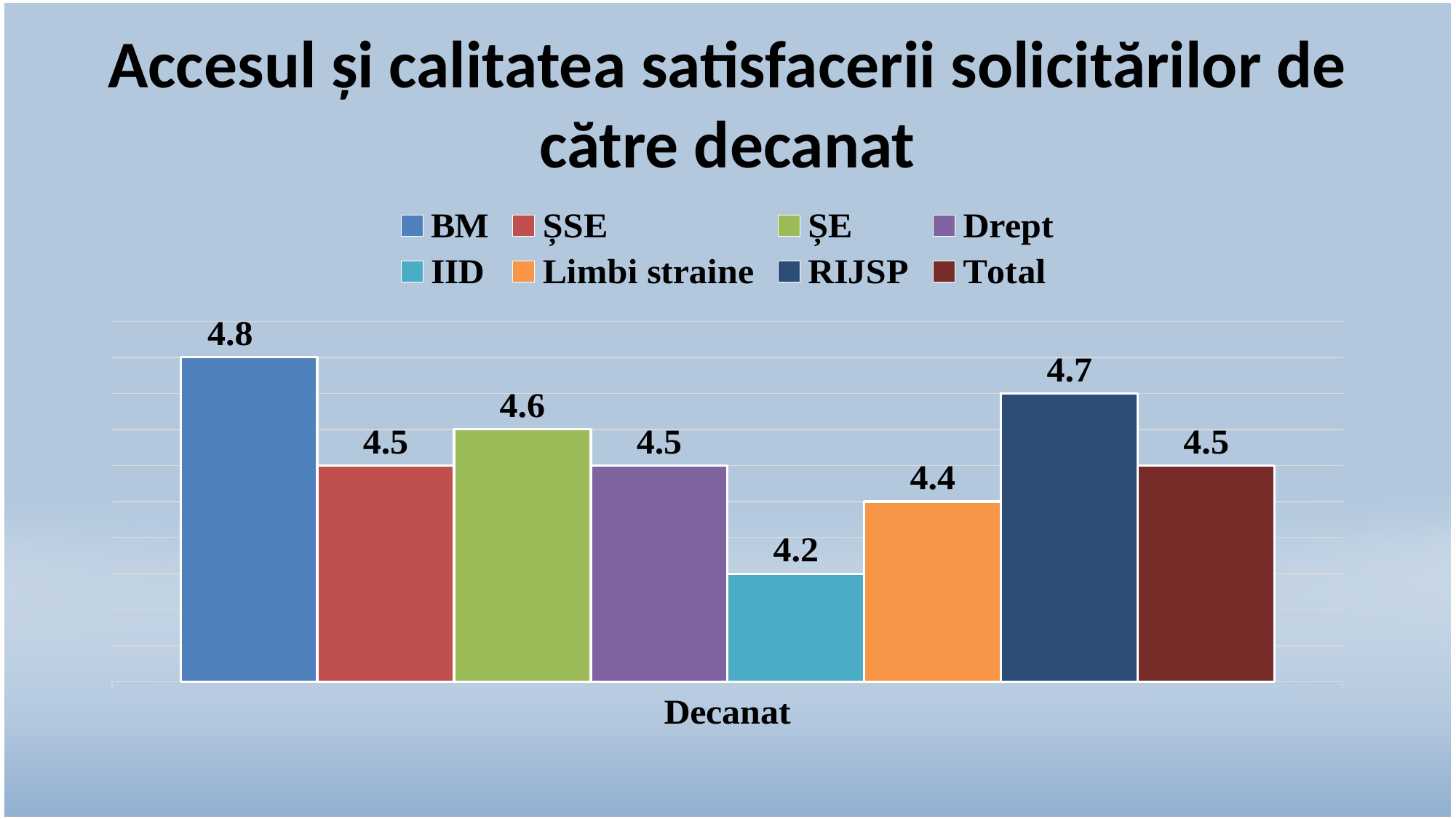
Which series has the lowest value? IID What is the value for RIJSP? 4.7 What is the difference between the values for BM and IID? 0.6 Which is larger, the value for ȘE or the value for Drept? ȘE What is the label on the x axis? Decanat What is the value for Limbi straine? 4.4 What is the value for BM? 4.8 Which series has the highest value? BM What is the value for IID? 4.2 What kind of chart is shown? Bar chart How many series does the legend list? 8 What is the difference between the values for RIJSP and Limbi straine? 0.3